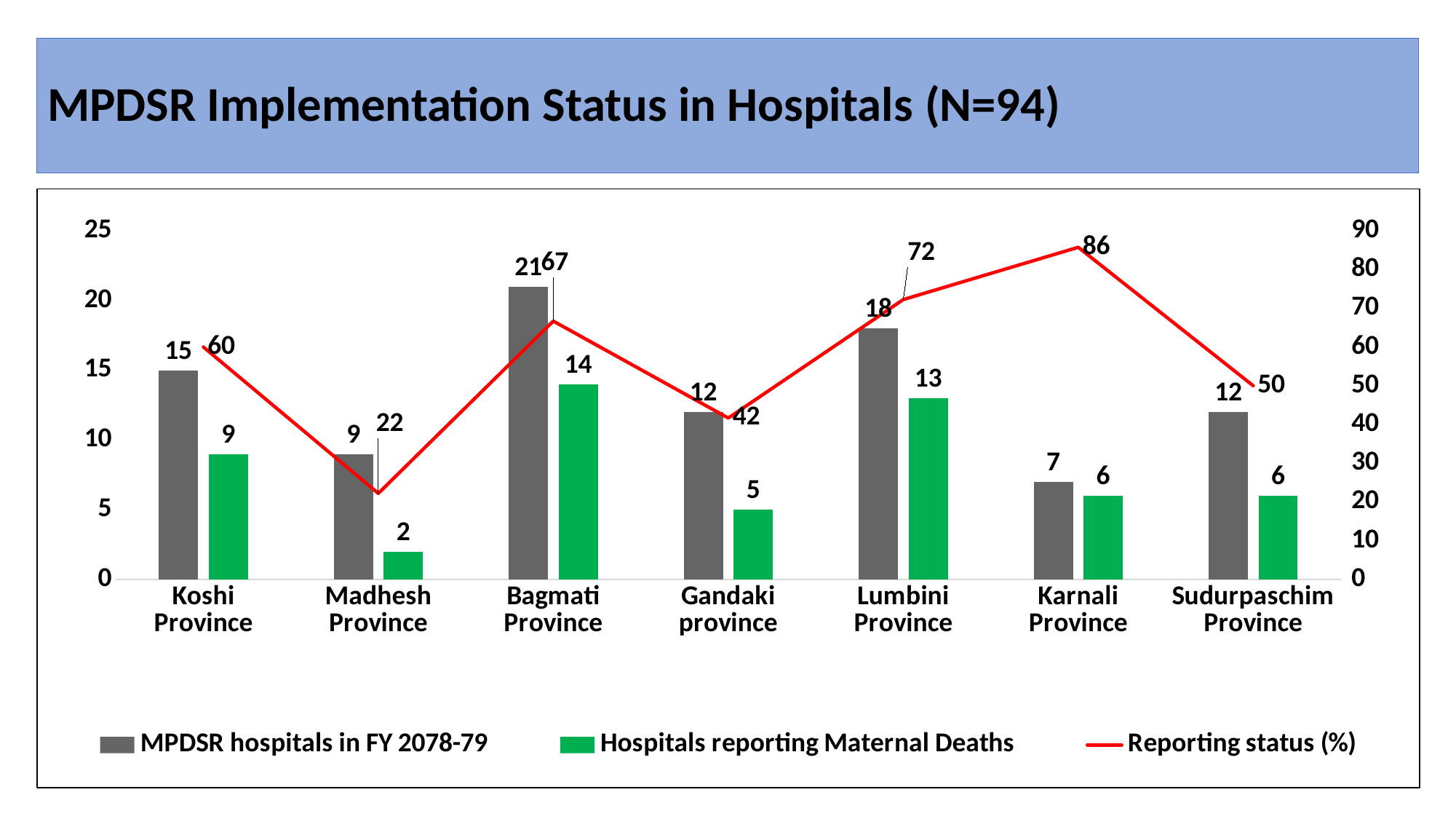
What is the difference between the number of MPDSR hospitals and the number of hospitals reporting maternal deaths in Gandaki province? 7 How many MPDSR hospitals in FY 2078-79 are shown for Bagmati Province? 21 Which province has the lowest number of hospitals reporting maternal deaths? Madhesh Province Which is larger: the reporting status (%) for Koshi Province or for Sudurpaschim Province? Koshi Province What is the reporting status (%) for Karnali Province? 86 Which province has the highest number of MPDSR hospitals in FY 2078-79? Bagmati Province What kind of chart is this? Combined bar and line chart What is the title of the slide? MPDSR Implementation Status in Hospitals (N=94) How many hospitals reporting maternal deaths are shown for Lumbini Province? 13 How many provinces are shown on the x axis? 7 How many series does the legend list? 3 Which province has the lowest reporting status (%)? Madhesh Province